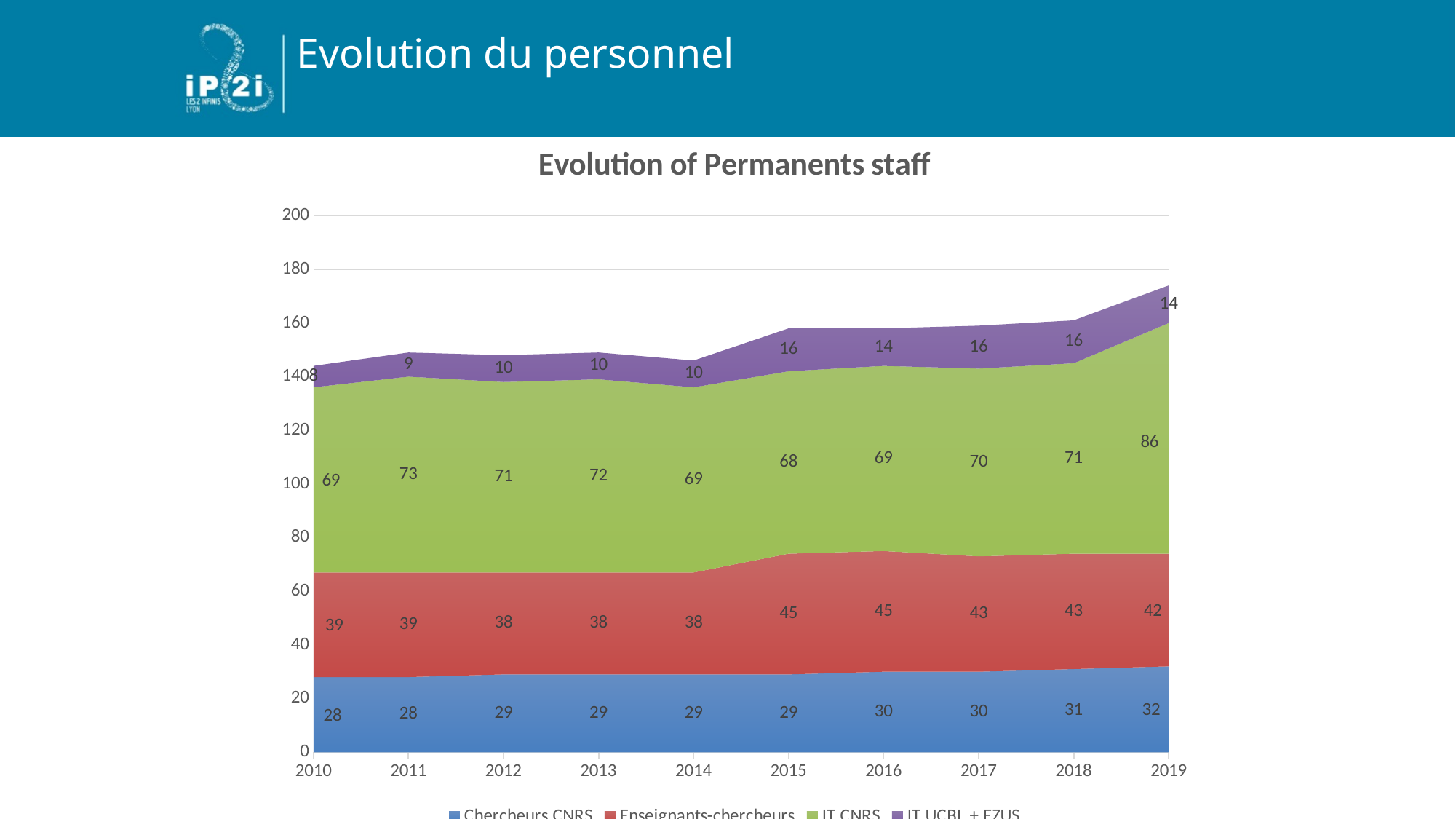
What is the total of all four series in 2019? 174 In which year is the IT CNRS value highest? 2019 How many years are shown on the x axis? 10 How many series does the legend list? 4 Which is larger, the Enseignants-chercheurs value in 2016 or in 2019? 2016 What is the title of the chart? Evolution of Permanents staff What is the value for Enseignants-chercheurs in 2015? 45 What is the value for IT CNRS in 2019? 86 What type of chart is shown on the slide? Stacked area chart What is the value for IT UCBL + EZUS in 2017? 16 What is the difference between the IT CNRS values in 2019 and 2018? 15 What is the value for Chercheurs CNRS in 2010? 28